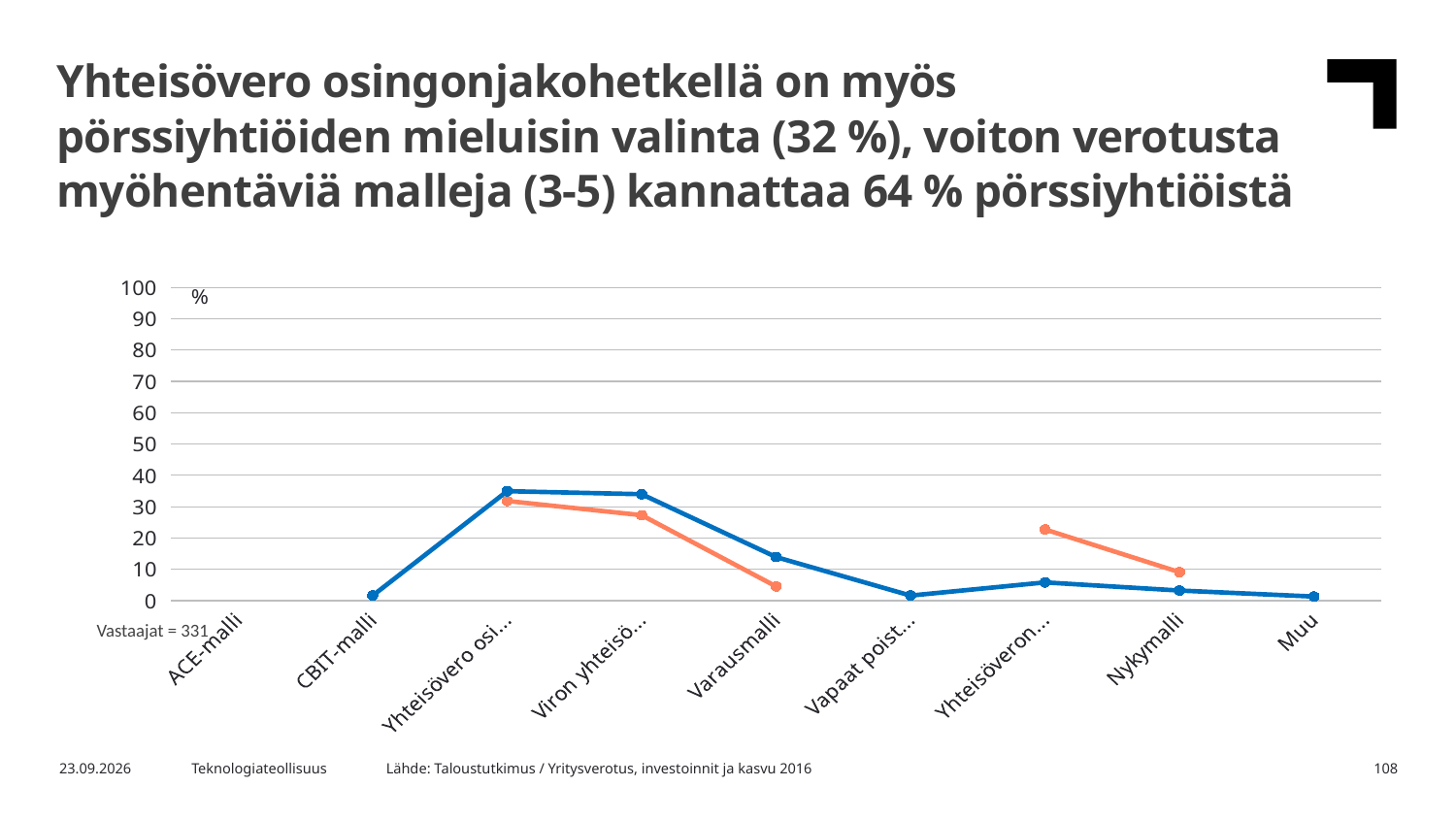
Is the value of the blue line for Varausmalli greater or less than 10? greater Is the value of the orange line for Yhteisöveron... greater or less than 20? greater What unit is shown at the top of the y axis? % For which category does the orange line reach its highest value? Yhteisövero osi... What kind of chart is shown on the slide? line chart For Varausmalli, which line has the larger value, the blue line or the orange line? the blue line Is the value of the blue line for Muu greater or less than 10? less Does the blue line rise or fall between Viron yhteisö... and Vapaat poist...? fall How many respondents (Vastaajat) are noted below the chart? 331 How many categories are shown on the x axis of the chart? 9